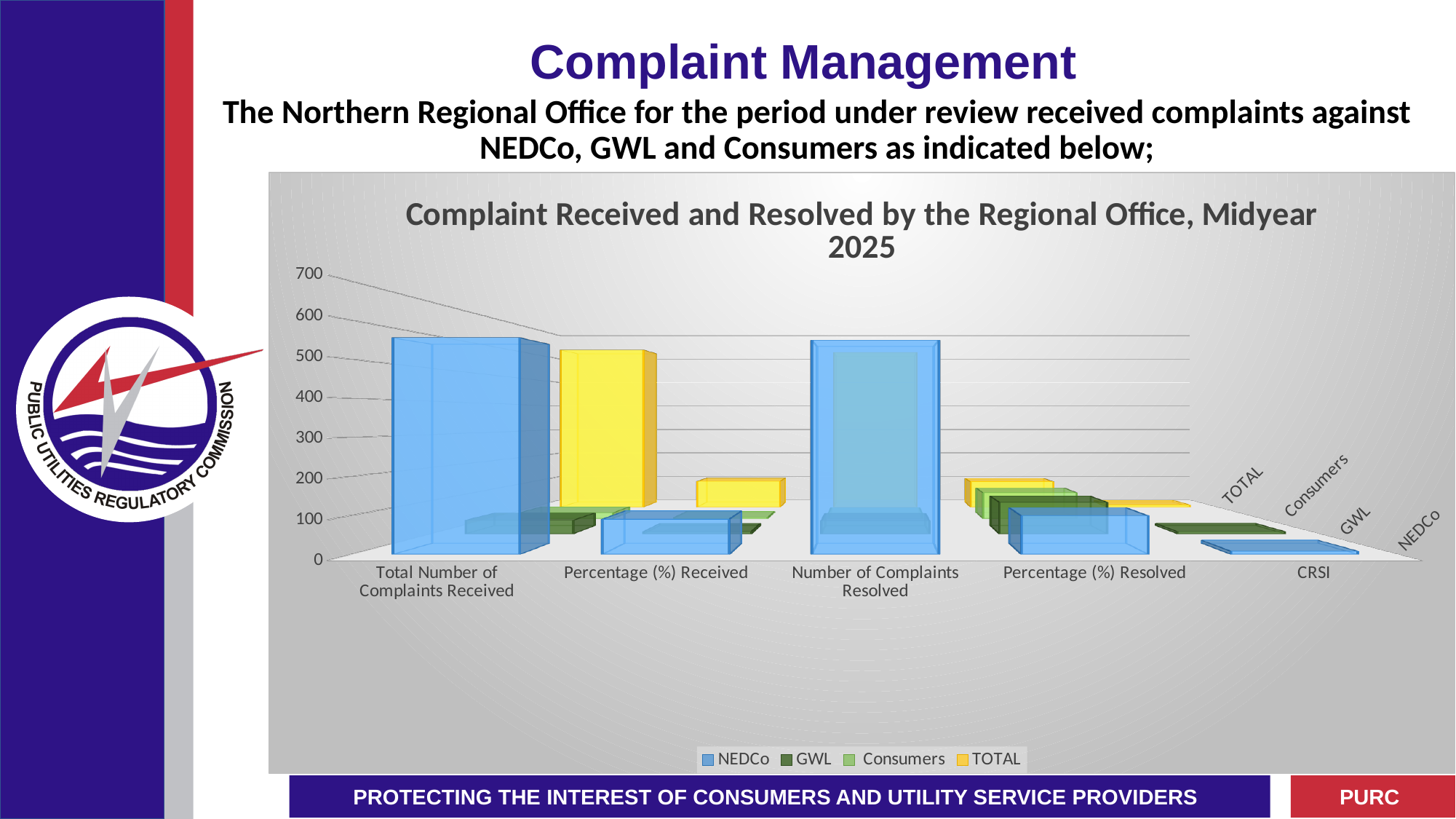
For Total Number of Complaints Received, which is larger: the NEDCo value or the GWL value? NEDCo How many series does the chart legend list? 4 What is the title of the chart? Complaint Received and Resolved by the Regional Office, Midyear 2025 How many categories are shown along the x axis of the chart? 5 Which series has the highest value for Total Number of Complaints Received? TOTAL Is the GWL value for Percentage (%) Received greater or less than 300? less What kind of chart is shown on the slide? bar chart Is the NEDCo value for Total Number of Complaints Received greater or less than 300? greater Is the NEDCo value for Number of Complaints Resolved greater or less than 300? greater Which series is shown in yellow in the chart legend? TOTAL